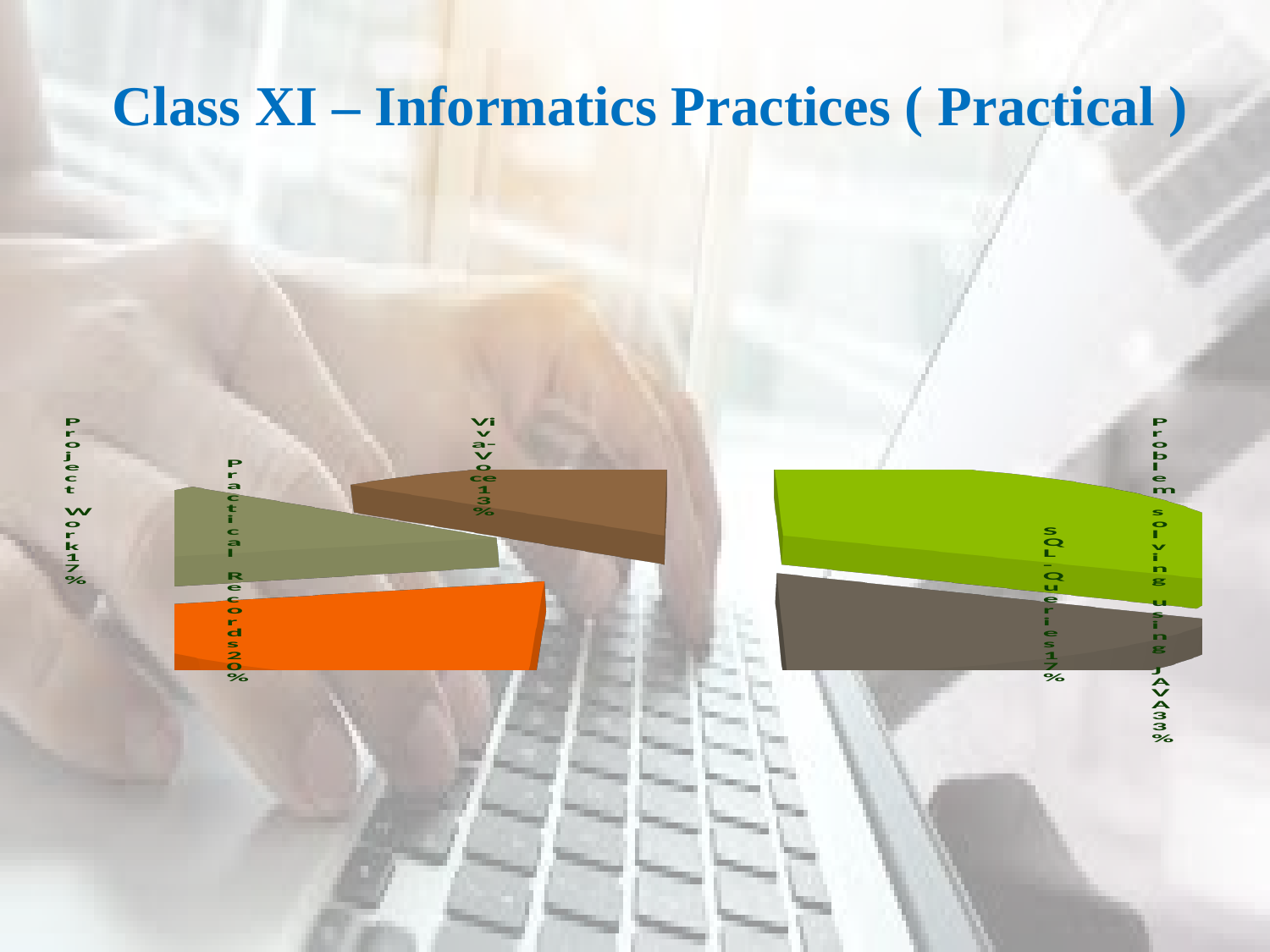
What is the difference between the shares of Problem solving using JAVA and Practical Records? 13% Which is larger, the share for Practical Records or the share for Viva-Voce? Practical Records What percentage is shown for SQL Queries? 17% What kind of chart is shown on the slide? pie chart What percentage is shown for Practical Records? 20% What percentage is shown for Problem solving using JAVA? 33% Which component has the smallest share of the pie? Viva-Voce How many slices does the pie chart have? 5 What is the title of the slide containing the chart? Class XI – Informatics Practices ( Practical ) What percentage is shown for Viva-Voce? 13% Which component has the largest share of the pie? Problem solving using JAVA What percentage is shown for Project Work? 17%